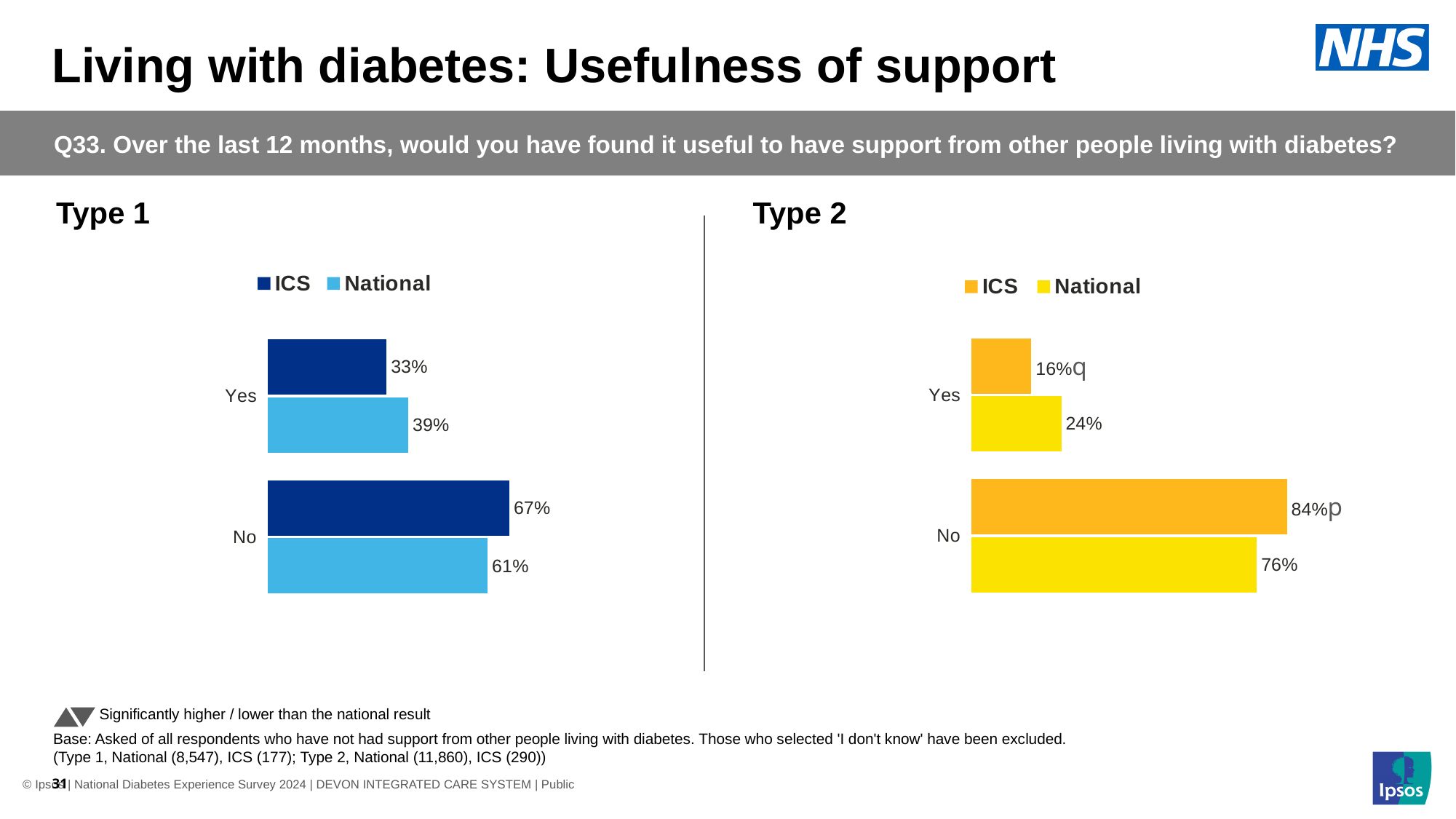
In the Type 2 chart, which is larger for No: ICS or National? ICS In the Type 2 chart, what is the ICS value for No? 84% In the Type 1 chart, what is the National value for No? 61% What kind of chart is the Type 2 chart? Bar chart In the Type 1 chart, what is the difference between the ICS and National values for No? 6 percentage points In the Type 1 chart, what is the ICS value for Yes? 33% How many series does the legend of the Type 1 chart list? 2 In the Type 2 chart, which response category has the lowest ICS value? Yes In the Type 2 chart, what is the National value for Yes? 24% In the Type 2 chart, what is the difference between the National and ICS values for Yes? 8 percentage points In the Type 1 chart, which is larger for Yes: ICS or National? National How many response categories are shown in the Type 1 chart? 2